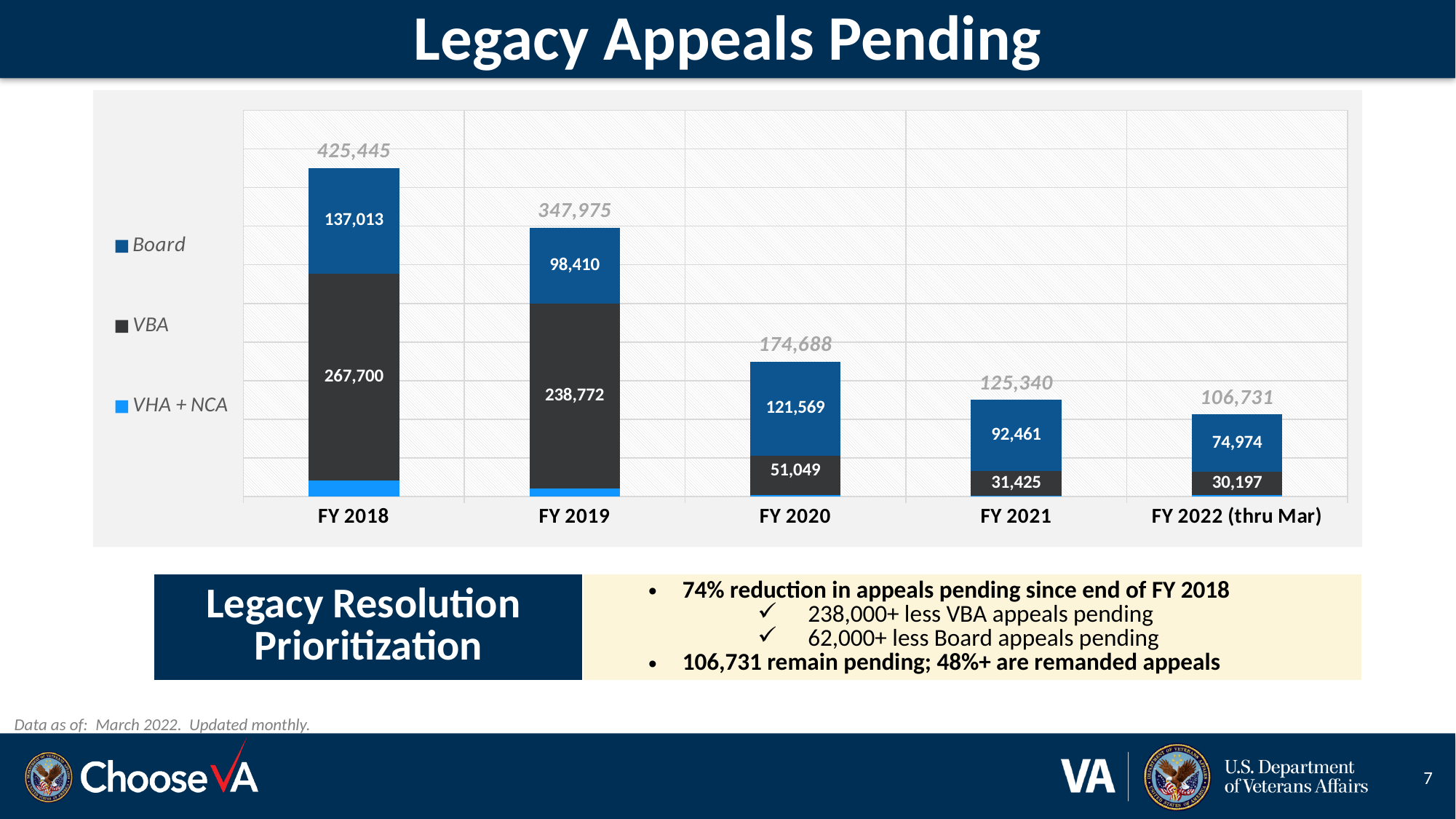
How many series does the legend list? 3 What is the VBA value for FY 2019? 238,772 Which fiscal year has the highest Board value? FY 2018 Which is larger in FY 2020, the Board value or the VBA value? Board What is the Board value for FY 2020? 121,569 Which fiscal year has the lowest total of legacy appeals pending? FY 2022 (thru Mar) What is the total number of legacy appeals pending in FY 2018? 425,445 What is the difference between the total for FY 2018 and the total for FY 2022 (thru Mar)? 318,714 How many fiscal year categories are shown on the x axis? 5 What is the VBA value for FY 2022 (thru Mar)? 30,197 Do the total legacy appeals pending rise or fall from FY 2018 to FY 2022 (thru Mar)? fall What is the difference between the Board values for FY 2018 and FY 2019? 38,603